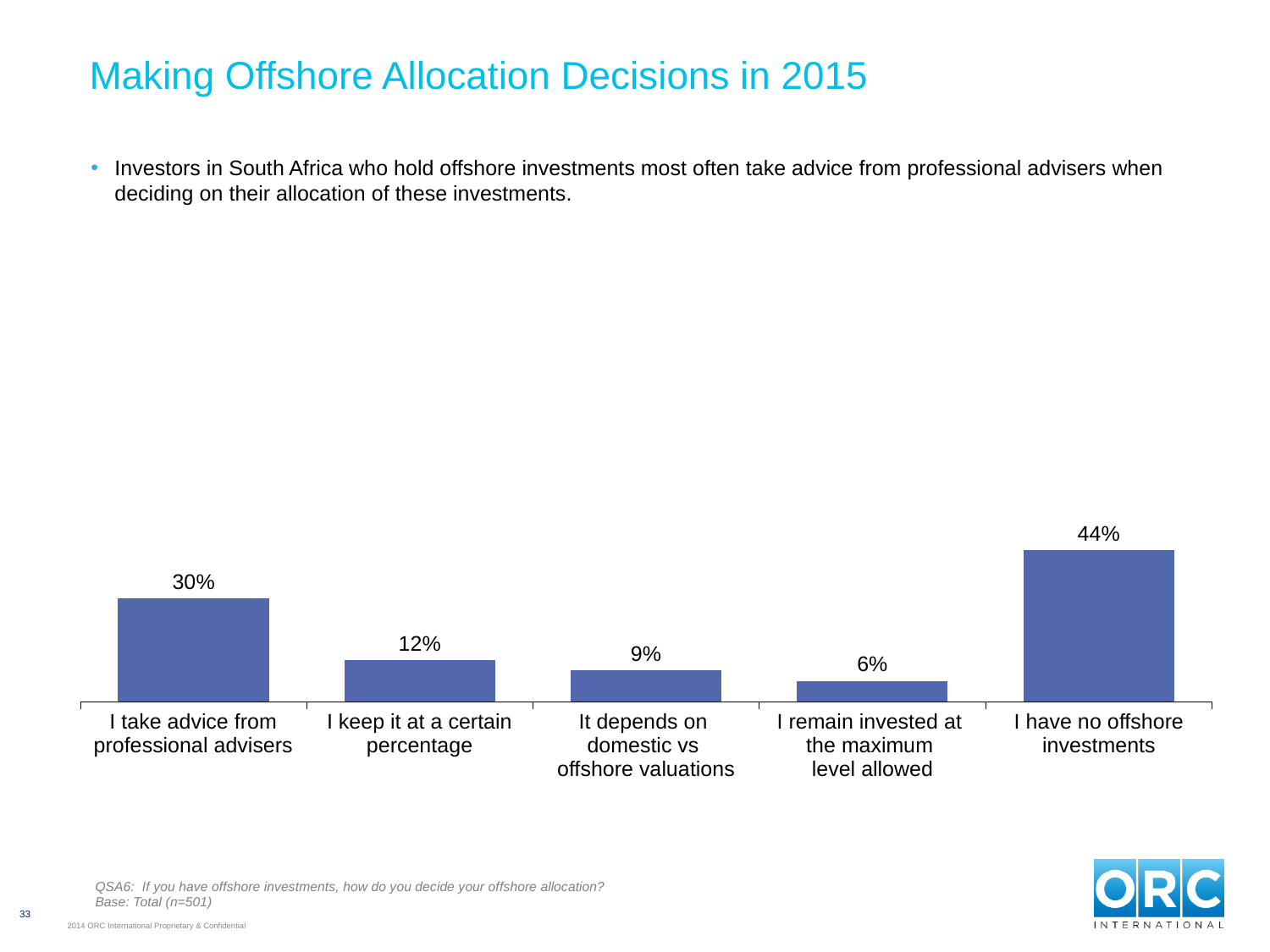
How many categories are shown in the chart? 5 What is the value for 'I remain invested at the maximum level allowed'? 6% What is the difference between 'I have no offshore investments' and 'I take advice from professional advisers'? 14% What is the value for 'I keep it at a certain percentage'? 12% What percentage of investors say it depends on domestic vs offshore valuations? 9% Which category has the highest value? I have no offshore investments Which category has the lowest value? I remain invested at the maximum level allowed What is the difference between 'I keep it at a certain percentage' and 'It depends on domestic vs offshore valuations'? 3% Which is larger: 'I take advice from professional advisers' or 'I keep it at a certain percentage'? I take advice from professional advisers What percentage of investors say they take advice from professional advisers? 30% What is the title of the slide containing the chart? Making Offshore Allocation Decisions in 2015 What type of chart is shown on the slide? Bar chart